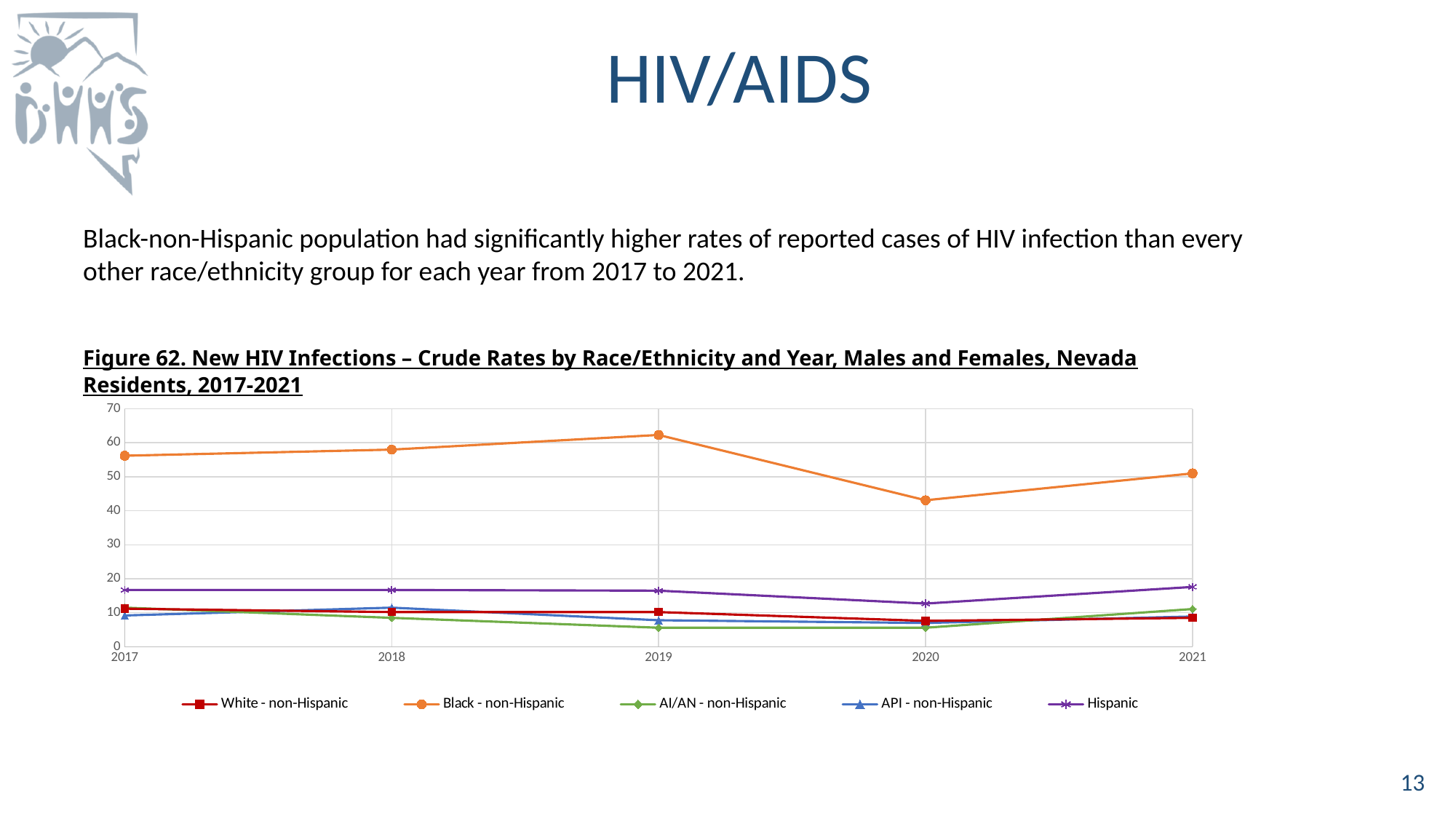
Is the Black - non-Hispanic rate in 2020 greater or less than 50? less In which year is the Black - non-Hispanic rate at its highest? 2019 Which is larger in 2020, the Black - non-Hispanic rate or the Hispanic rate? Black - non-Hispanic In which year is the Black - non-Hispanic rate at its lowest? 2020 How many series does the legend of Figure 62 list? 5 Does the Black - non-Hispanic rate rise or fall from 2019 to 2020? fall What colour is the line for the Black - non-Hispanic series? orange Which race/ethnicity group has the highest crude rate in 2021? Black - non-Hispanic Is the Hispanic rate in 2017 greater or less than 20? less What kind of chart is shown in Figure 62? line chart How many years are plotted along the x axis of Figure 62? 5 Is the Black - non-Hispanic rate in 2019 greater or less than 60? greater